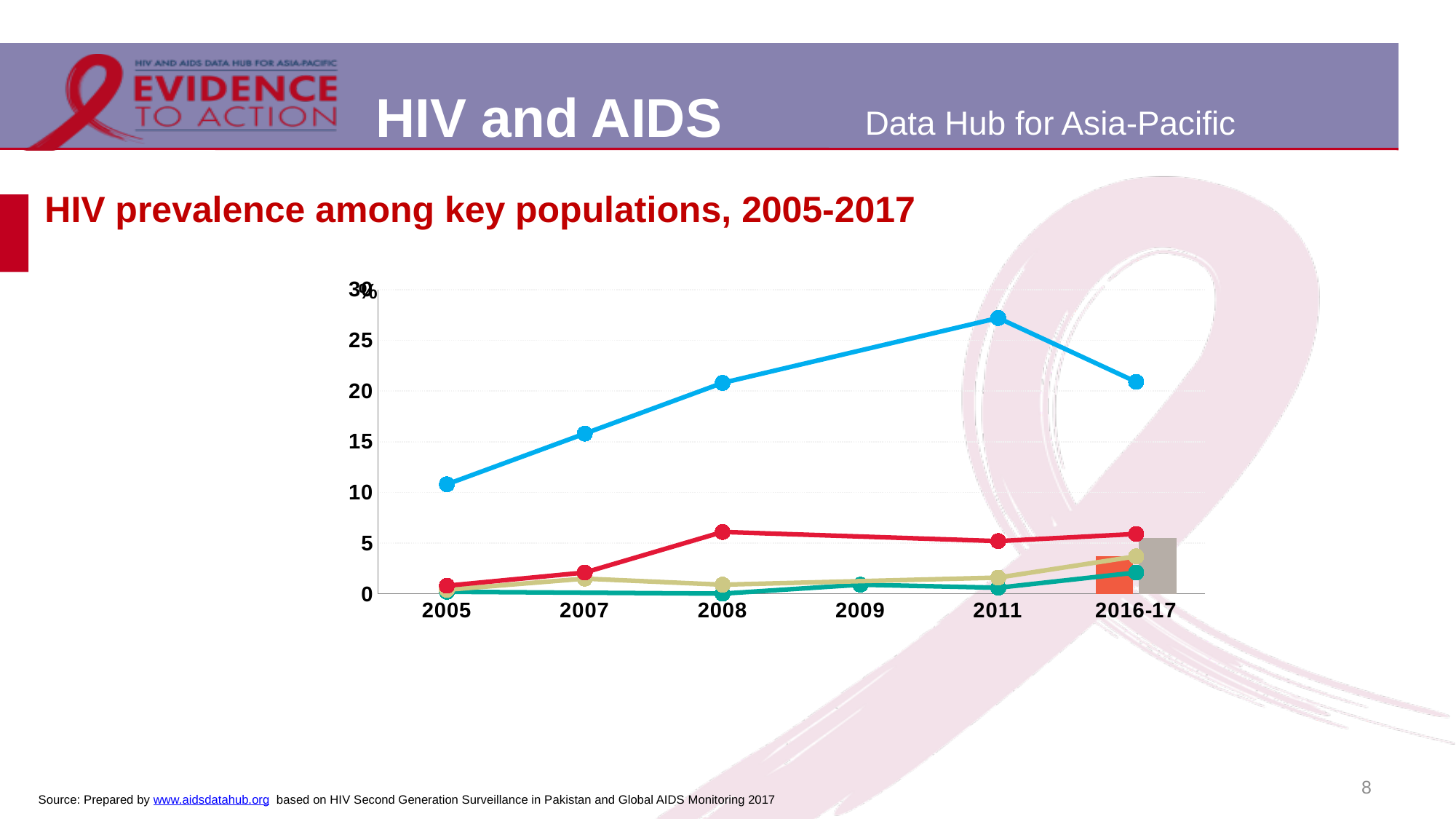
What kind of chart is shown on the slide? combination bar and line chart Is the value of the red line in 2005 greater or less than 5? less In which year is the blue line at its lowest value? 2005 Does the blue line rise or fall between 2011 and 2016-17? fall Is the value of the red line in 2008 greater or less than 5? greater Which line has the larger value in 2008, the blue line or the red line? the blue line In which year does the blue line reach its highest value? 2011 What is the title of the chart on the slide? HIV prevalence among key populations, 2005-2017 Is the value of the blue line in 2008 greater or less than 20? greater Does the blue line rise or fall between 2005 and 2011? rise How many time points are shown on the x axis of the chart? 6